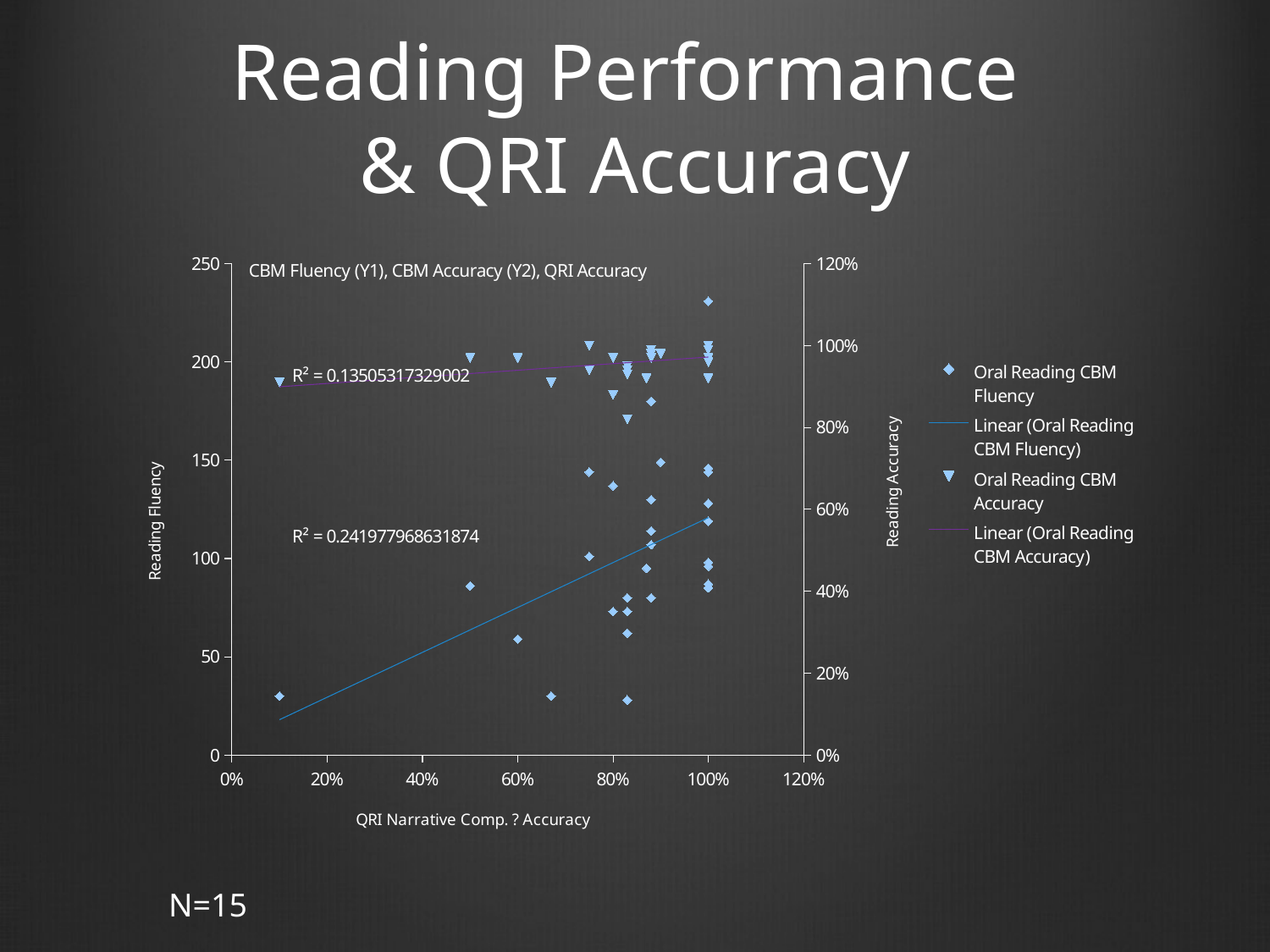
Does the linear trendline for Oral Reading CBM Fluency rise or fall as QRI accuracy increases? rises What kind of chart is shown on the slide? scatter chart What is the smaller R² value printed on the chart? 0.13505317329002 What is the title of the left vertical axis? Reading Fluency How many entries does the chart legend list? 4 Is the Oral Reading CBM Fluency value at 60% QRI accuracy greater or less than 100? less What is the title of the chart? CBM Fluency (Y1), CBM Accuracy (Y2), QRI Accuracy Is the Oral Reading CBM Accuracy value at 10% QRI accuracy greater or less than 80%? greater At which QRI accuracy value does the highest Oral Reading CBM Fluency point occur? 100% What is the larger R² value printed on the chart? 0.241977968631874 What sample size (N) is stated on the slide? N=15 Is the highest Oral Reading CBM Fluency value on the chart greater or less than 200? greater